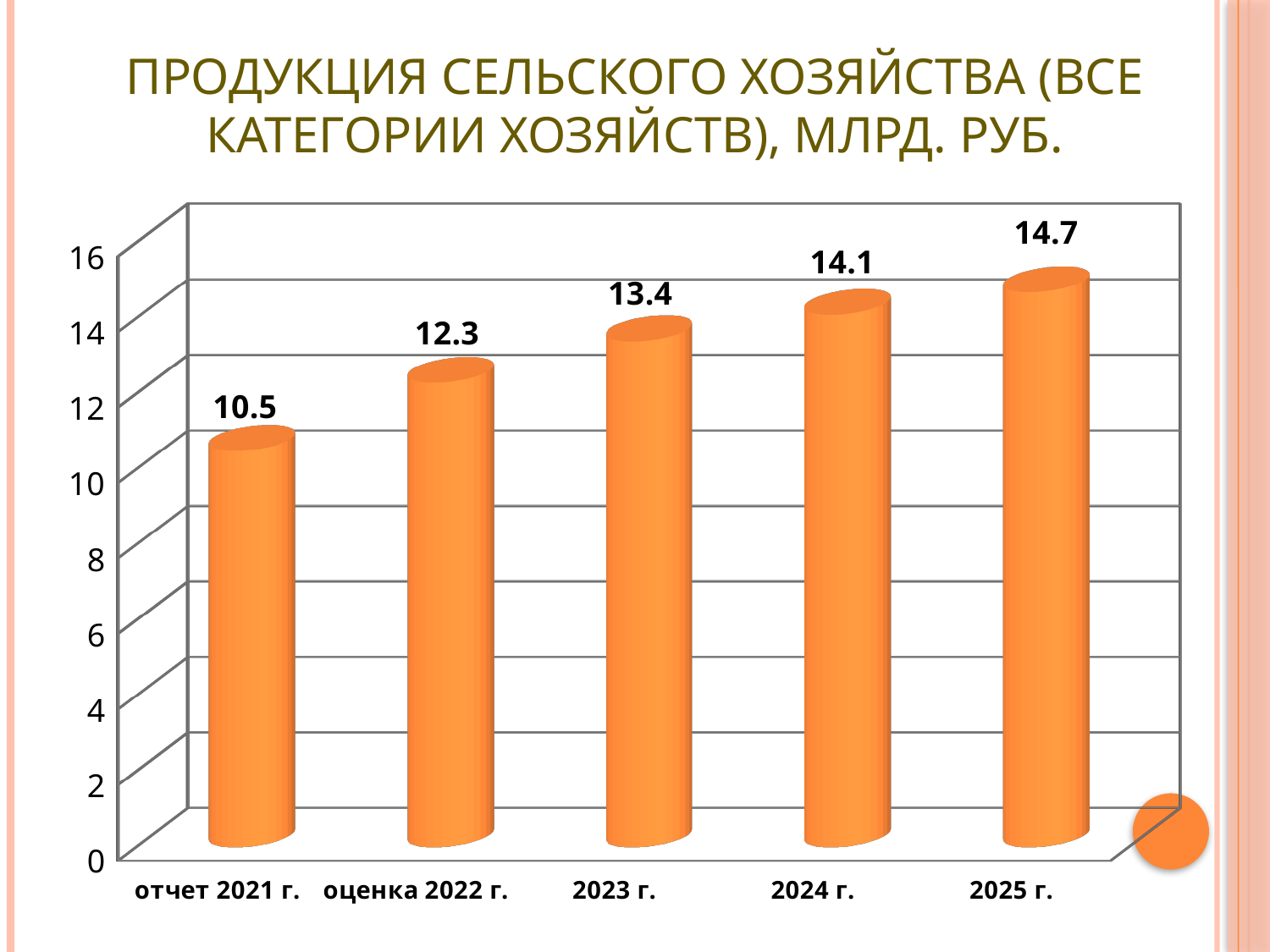
What is the difference between the values for 2023 г. and оценка 2022 г.? 1.1 Which is larger, the value for 2023 г. or the value for 2024 г.? 2024 г. What is the value for оценка 2022 г.? 12.3 What is the value for 2024 г.? 14.1 How many categories are shown on the x axis? 5 Which category has the lowest value? отчет 2021 г. Is the value for 2025 г. greater or less than 14? greater Which category has the highest value? 2025 г. What kind of chart is shown on the slide? bar chart Do the values rise or fall from отчет 2021 г. to 2025 г.? rise What is the value for отчет 2021 г.? 10.5 What is the difference between the values for 2025 г. and отчет 2021 г.? 4.2